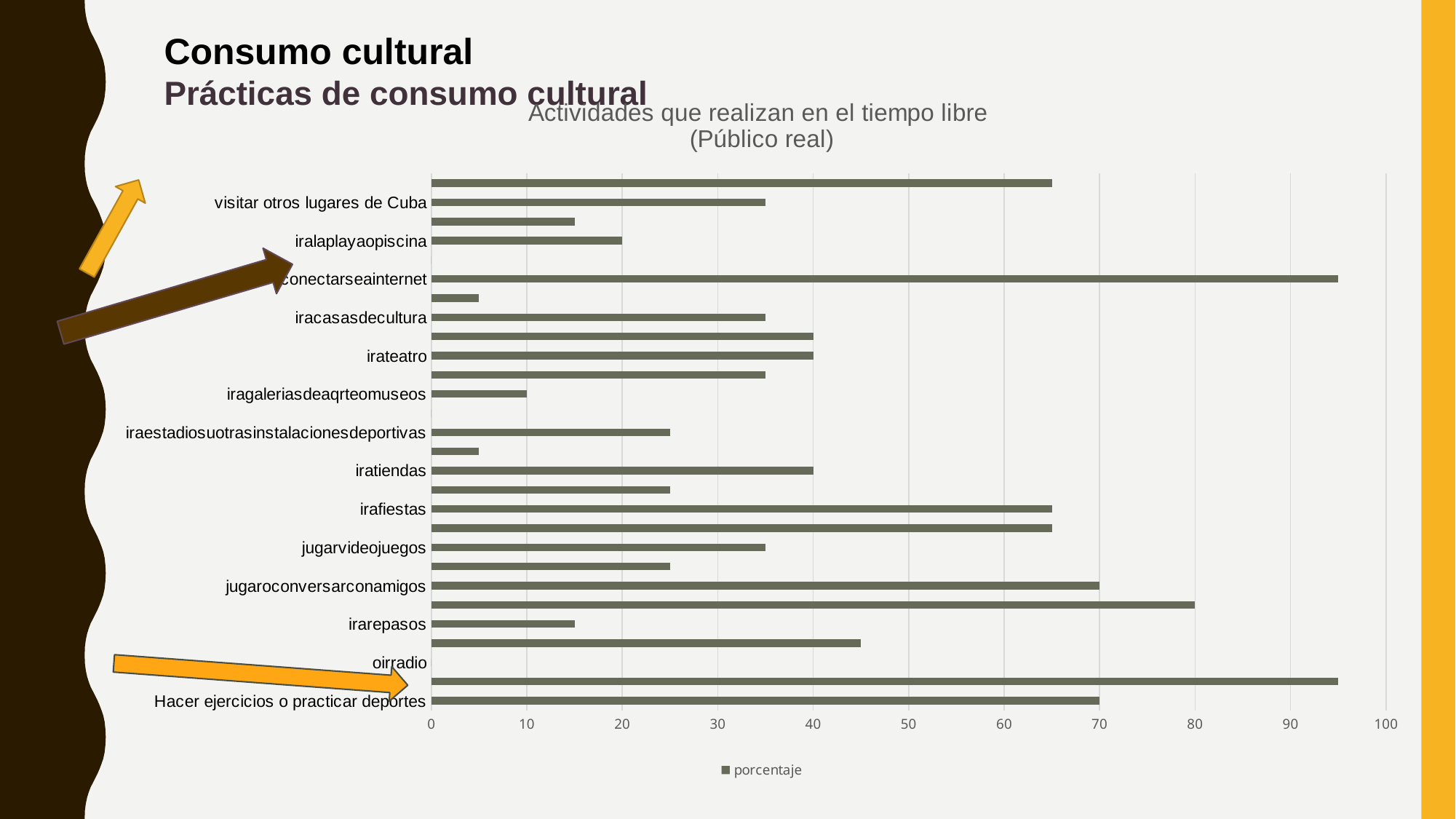
Is the value for irarepasos greater or less than 20? less Which has a larger value, iragaleriasdeaqrteomuseos or irafiestas? irafiestas What is the title of the chart? Actividades que realizan en el tiempo libre (Público real) What is the value for irateatro? 40 What is the value for iragaleriasdeaqrteomuseos? 10 Is the value for irafiestas greater or less than 60? greater Is the value for conectarseainternet greater or less than 90? greater How many series does the chart legend list? 1 What is the name of the series shown in the chart legend? porcentaje Which has a larger value, conectarseainternet or irarepasos? conectarseainternet What is the value for jugaroconversarconamigos? 70 What kind of chart is shown on the slide? bar chart